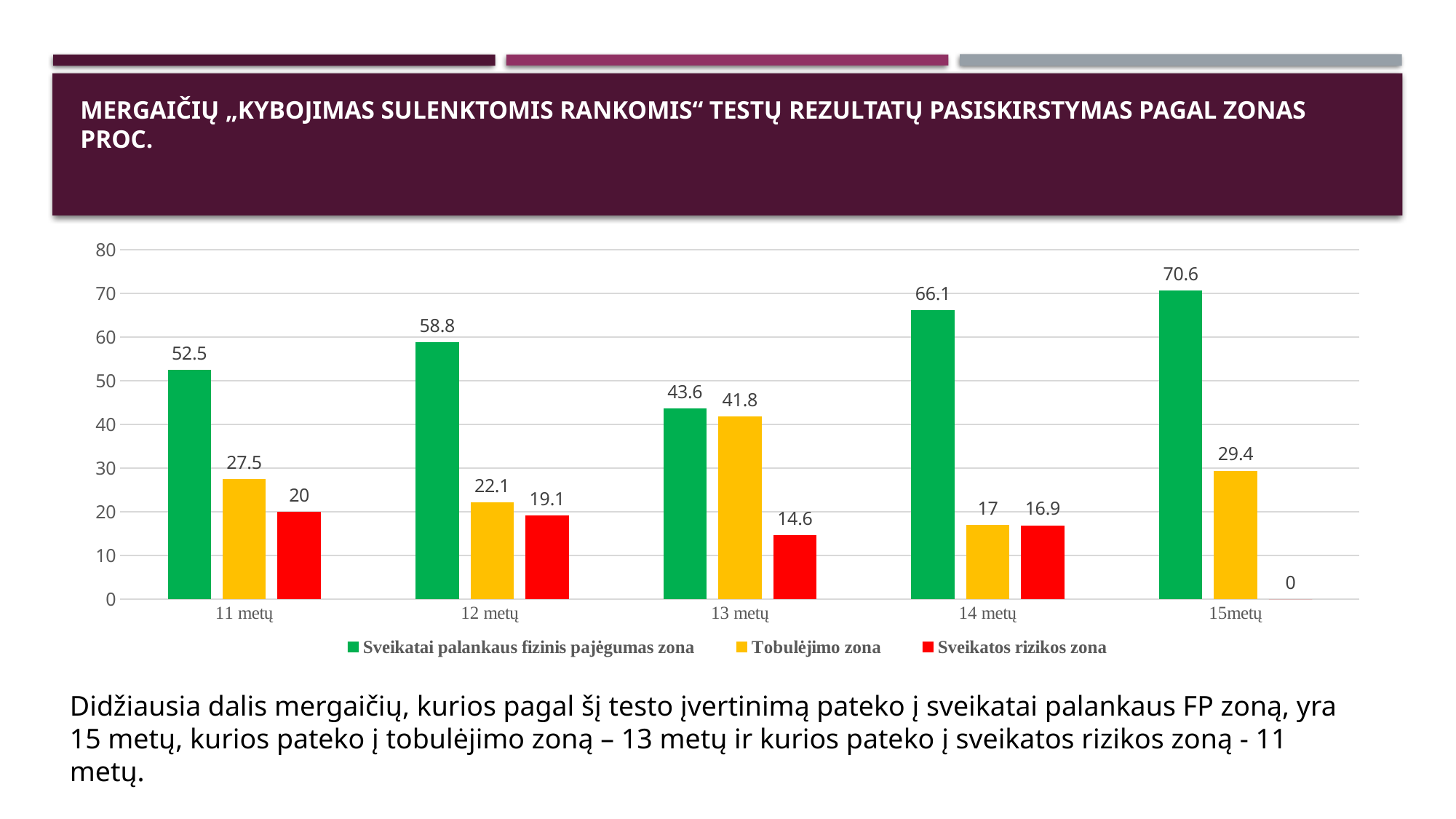
What is the difference between the Tobulėjimo zona values for 13 metų and 14 metų? 24.8 How many age groups are shown on the x axis? 5 At 11 metų, which is larger: Tobulėjimo zona or Sveikatos rizikos zona? Tobulėjimo zona What is the difference between the Sveikatai palankaus fizinis pajėgumas zona values for 14 metų and 13 metų? 22.5 What is the value for Tobulėjimo zona at 15metų? 29.4 What is the value for Sveikatai palankaus fizinis pajėgumas zona at 13 metų? 43.6 What is the value for Sveikatos rizikos zona at 12 metų? 19.1 Which age group has the lowest value for Sveikatos rizikos zona? 15metų What kind of chart is shown on the slide? Bar chart How many series does the legend list? 3 Which age group has the highest value for Tobulėjimo zona? 13 metų Which age group has the highest value for Sveikatai palankaus fizinis pajėgumas zona? 15metų